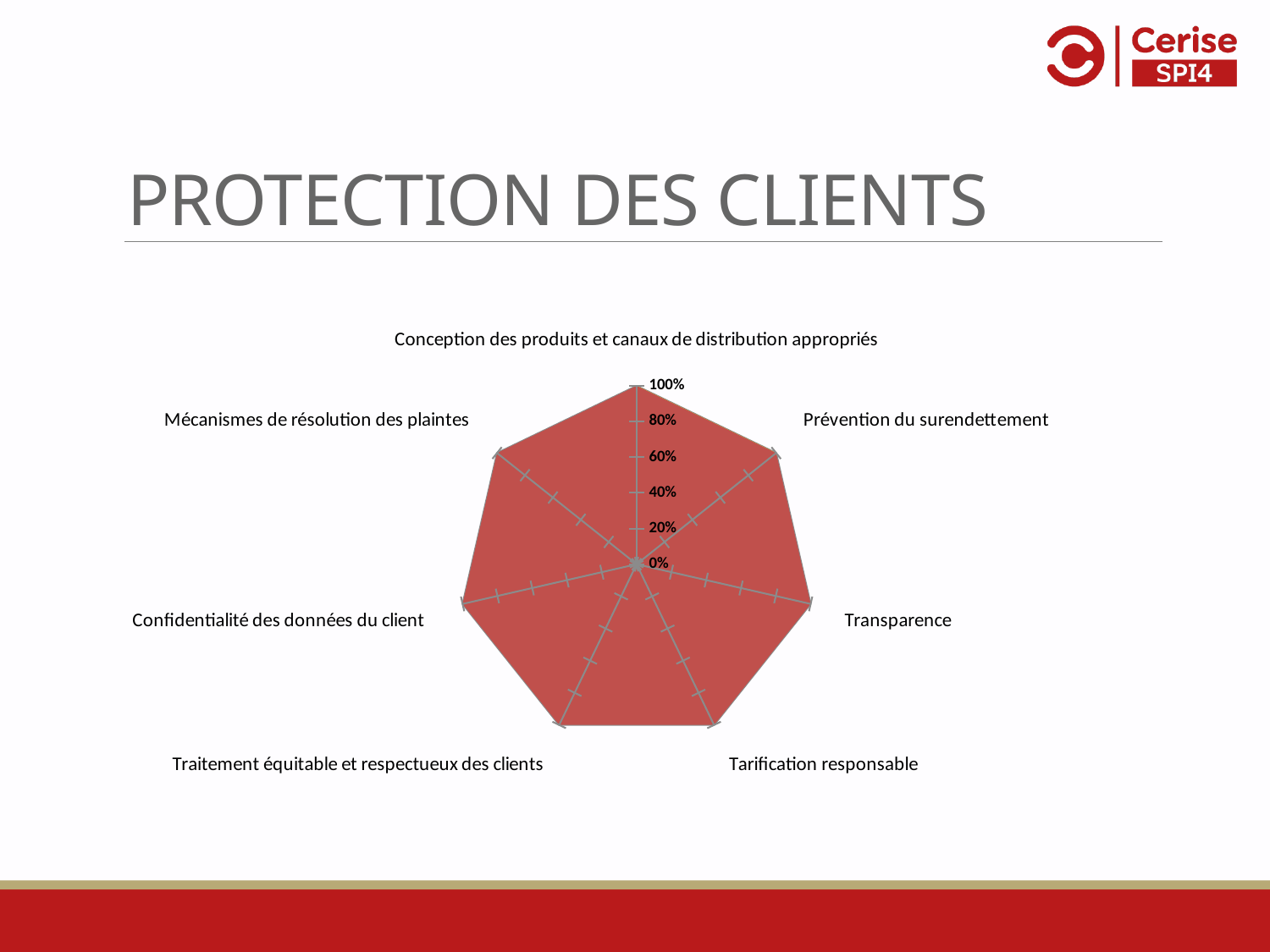
What is the value for Conception des produits et canaux de distribution appropriés? 100% Is the value for Tarification responsable greater or less than 80%? greater Is the value for Transparence greater or less than 60%? greater Is the value for Traitement équitable et respectueux des clients greater or less than 40%? greater What kind of chart is shown on the slide? radar chart What is the highest value shown on the radar chart's axis scale? 100% How many categories (axes) does the radar chart have? 7 What is the title of the slide containing the radar chart? PROTECTION DES CLIENTS